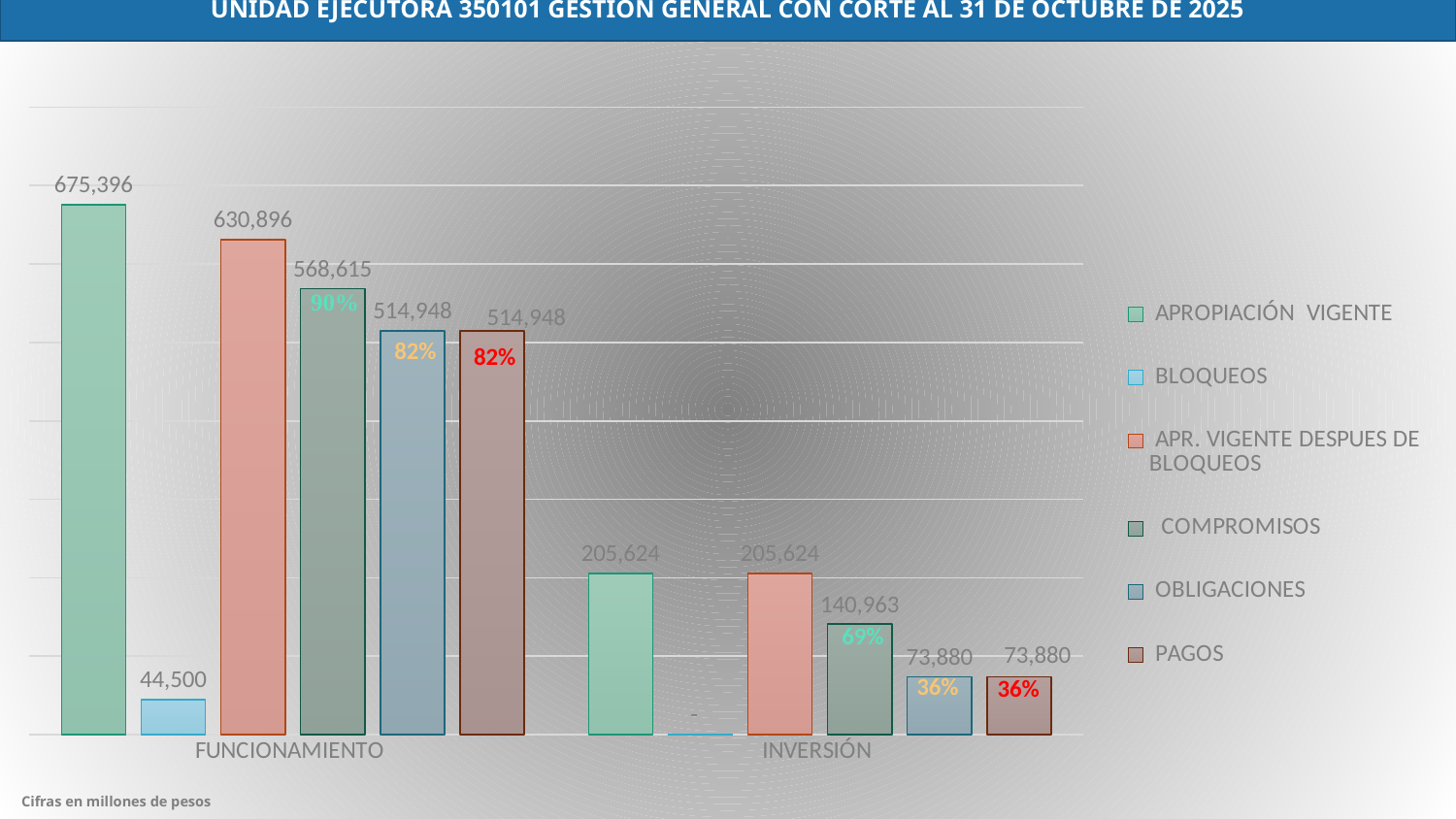
What kind of chart is shown on the slide? Bar chart Which series has the highest value for FUNCIONAMIENTO? APROPIACIÓN VIGENTE What is the APROPIACIÓN VIGENTE value for FUNCIONAMIENTO? 675,396 How many categories are shown on the x axis? 2 Which series has the lowest value for FUNCIONAMIENTO? BLOQUEOS What is the COMPROMISOS value for INVERSIÓN? 140,963 What is the APR. VIGENTE DESPUES DE BLOQUEOS value for FUNCIONAMIENTO? 630,896 What is the difference between the APROPIACIÓN VIGENTE value and the APR. VIGENTE DESPUES DE BLOQUEOS value for FUNCIONAMIENTO? 44,500 What is the PAGOS value for INVERSIÓN? 73,880 How many series does the legend list? 6 Which is larger: the COMPROMISOS value for FUNCIONAMIENTO or the COMPROMISOS value for INVERSIÓN? FUNCIONAMIENTO What is the BLOQUEOS value for FUNCIONAMIENTO? 44,500